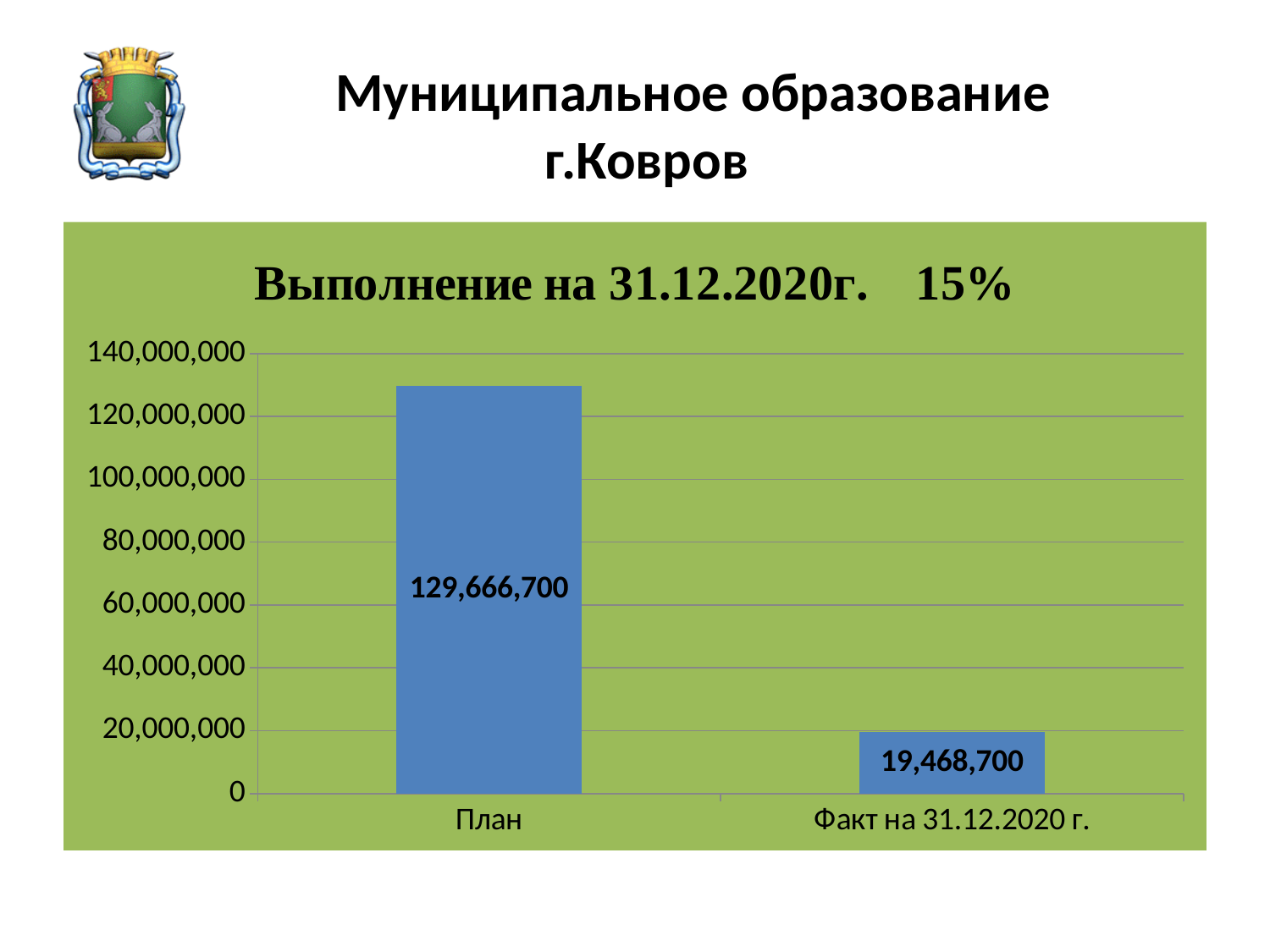
What is the highest value shown on the y axis? 140,000,000 Which is larger, the value for План or the value for Факт на 31.12.2020 г.? План Is the value for Факт на 31.12.2020 г. greater or less than 20,000,000? less Is the value for План greater or less than 120,000,000? greater Which category has the highest value? План What is the title of the chart? Выполнение на 31.12.2020г. 15% What is the value for Факт на 31.12.2020 г.? 19,468,700 How many categories are shown on the x axis? 2 What kind of chart is shown on the slide? bar chart What is the difference between the value for План and the value for Факт на 31.12.2020 г.? 110,198,000 Which category has the lowest value? Факт на 31.12.2020 г. What is the value for План? 129,666,700